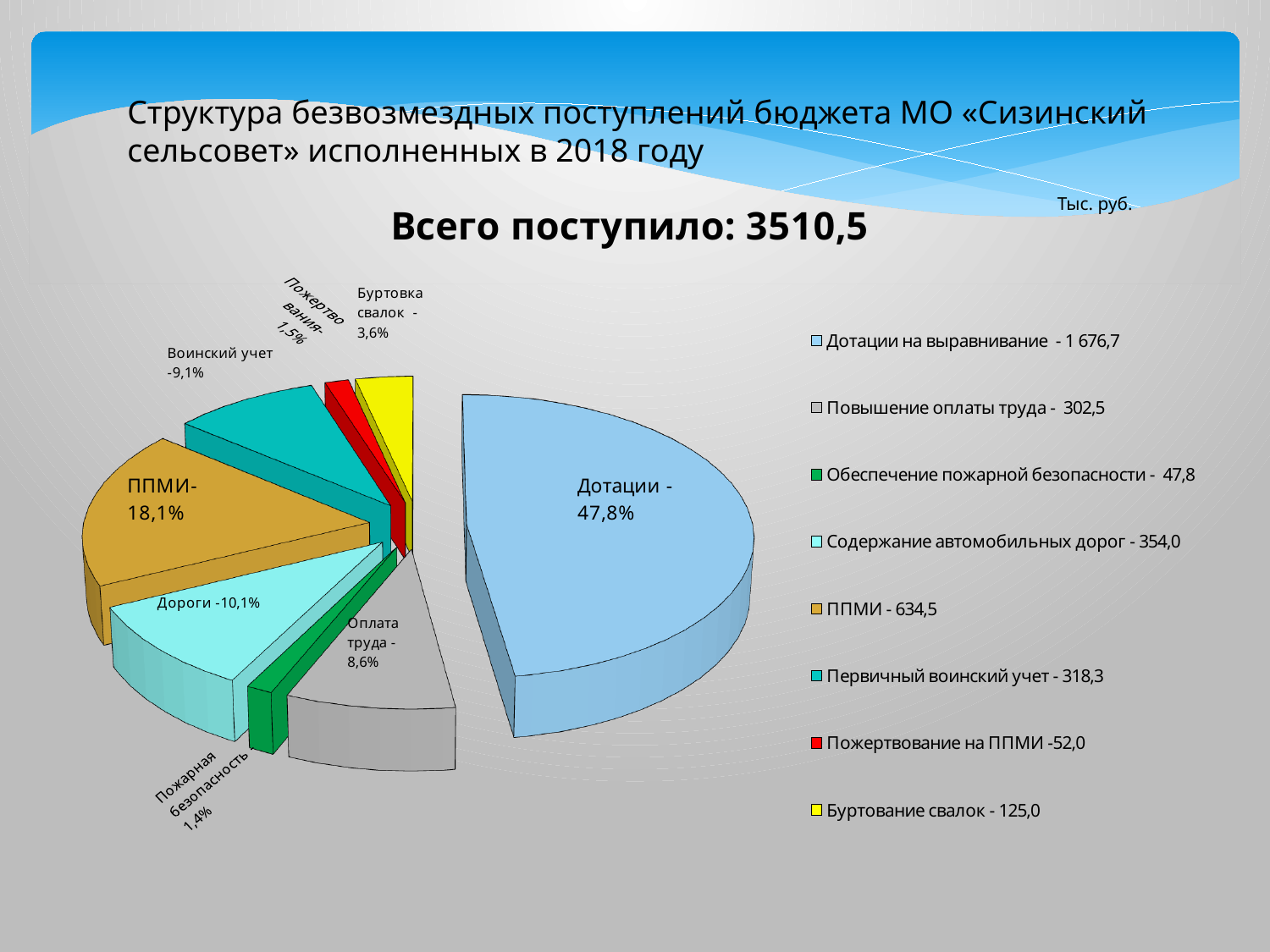
How many slices does the pie chart have? 8 What is the difference between the legend values for "ППМИ" and "Пожертвование на ППМИ"? 582,5 Which slice of the pie chart is the largest? Дотации What kind of chart is shown on the slide? pie chart What share of the pie does the slice "Дороги" represent? 10,1% According to the legend, what is the value for "Первичный воинский учет"? 318,3 Which is larger: the value for "Повышение оплаты труда" or the value for "Буртование свалок"? Повышение оплаты труда What share of the pie does the slice "ППМИ" represent? 18,1% Which slice of the pie chart is the smallest? Пожарная безопасность According to the legend, what is the value for "Содержание автомобильных дорог"? 354,0 What share of the pie does the slice "Дотации" represent? 47,8% What total amount received is stated above the chart? 3510,5